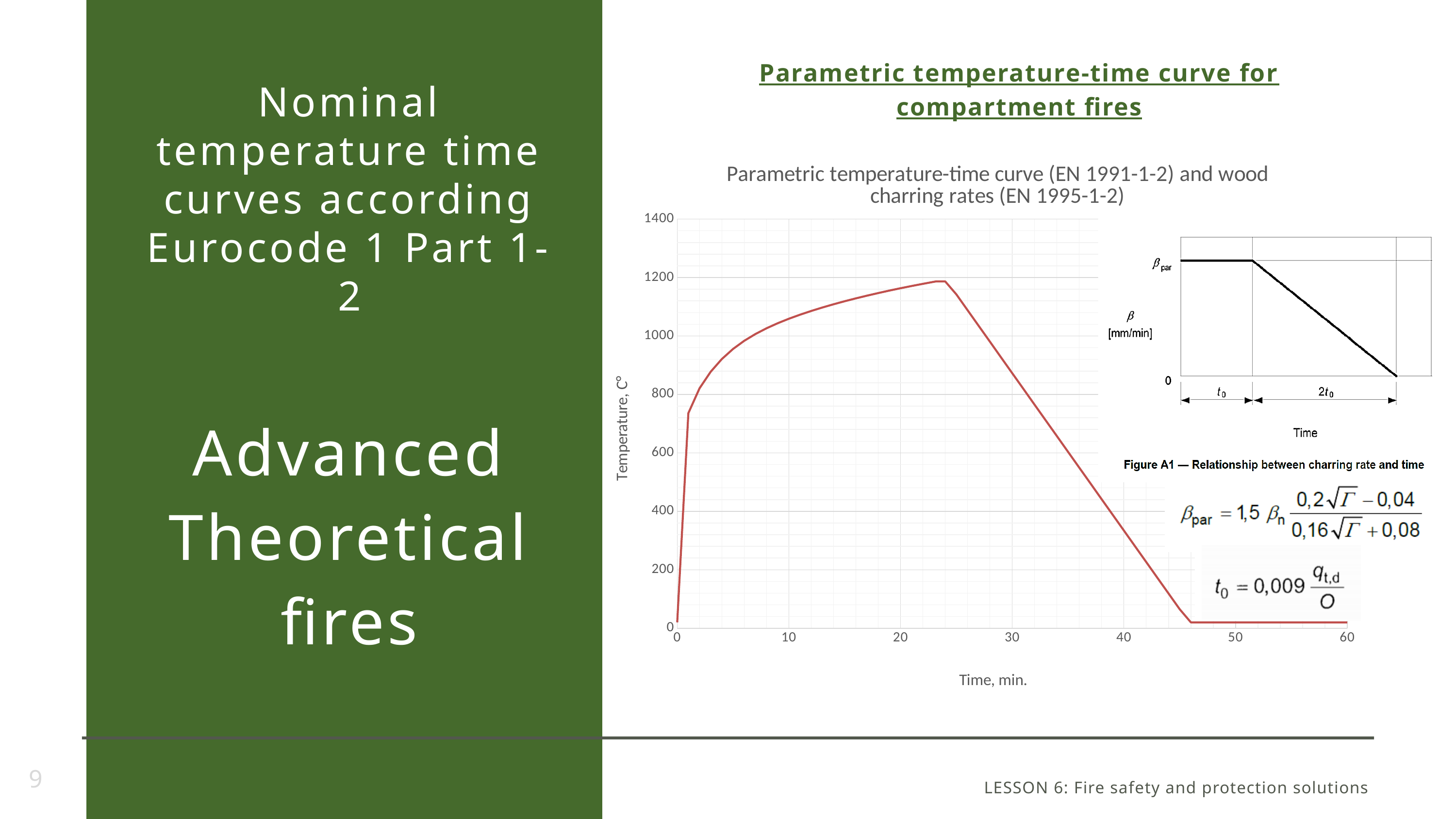
Does the temperature on the parametric temperature-time curve rise or fall between 0 min and 20 min? rise What kind of chart is the 'Parametric temperature-time curve (EN 1991-1-2) and wood charring rates (EN 1995-1-2)' chart? Line chart What is the title of the chart on the slide? Parametric temperature-time curve (EN 1991-1-2) and wood charring rates (EN 1995-1-2) Is the temperature at 10 min on the parametric temperature-time curve greater or less than 800? greater Is the temperature at 5 min on the parametric temperature-time curve greater or less than 800? greater Is the temperature at 50 min on the parametric temperature-time curve greater or less than 200? less Does the temperature on the parametric temperature-time curve rise or fall between 30 min and 40 min? fall Which is larger on the parametric temperature-time curve: the temperature at 20 min or the temperature at 40 min? 20 min What is the label of the horizontal axis of the temperature-time chart? Time, min.